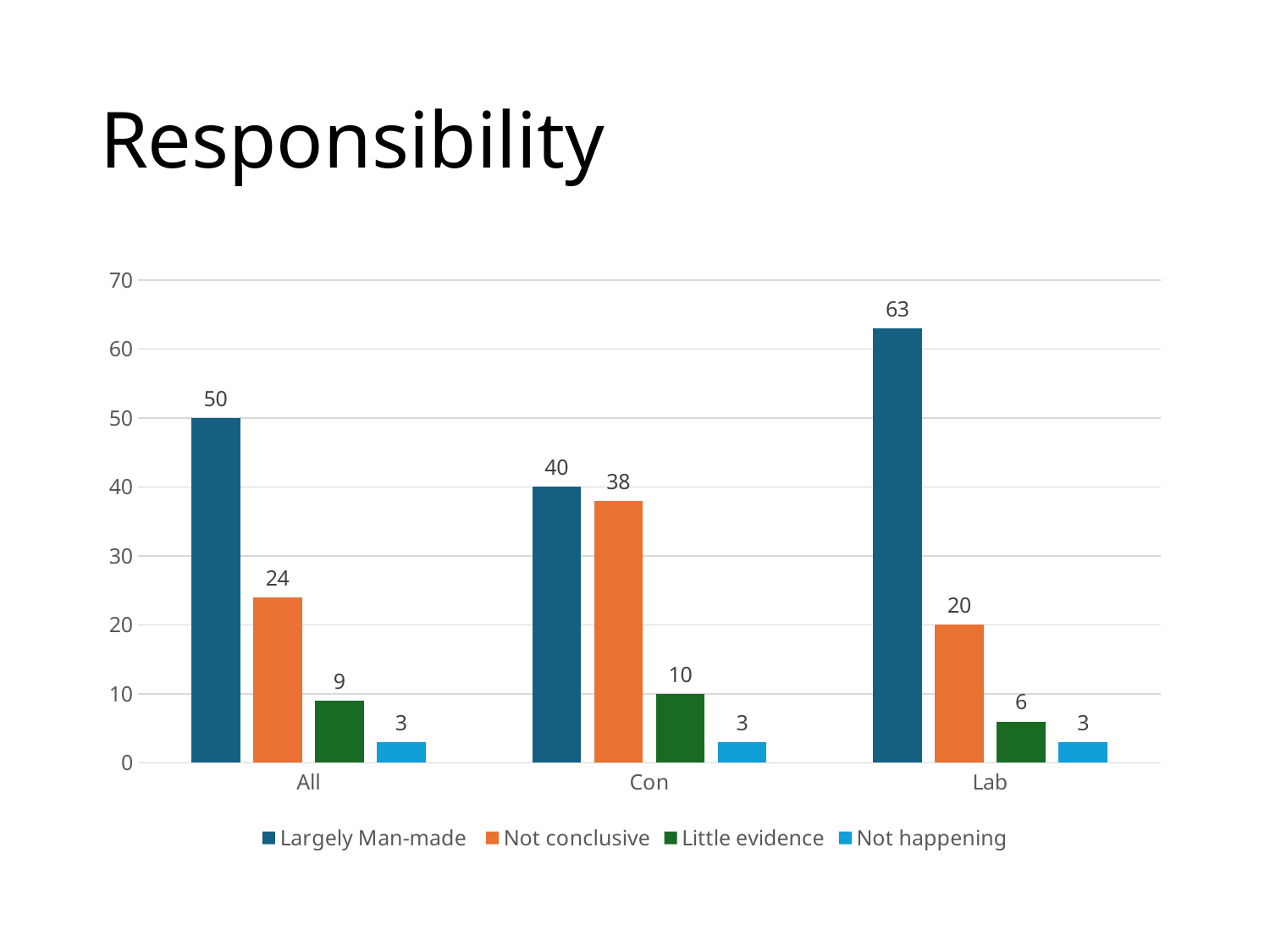
What is the value for Little evidence in the All category? 9 What is the value for Largely Man-made in the Lab category? 63 What kind of chart is shown on the slide? bar chart How many series does the legend list? 4 Which category has the highest value for Largely Man-made? Lab What is the difference between the Largely Man-made values for Lab and Con? 23 What is the title of the slide? Responsibility Which category has the lowest value for Little evidence? Lab Is the value for Largely Man-made in the Lab category greater or less than 60? greater What is the value for Not conclusive in the Con category? 38 Which is larger: Not conclusive for All or Not conclusive for Con? Con How many categories are shown on the x axis? 3